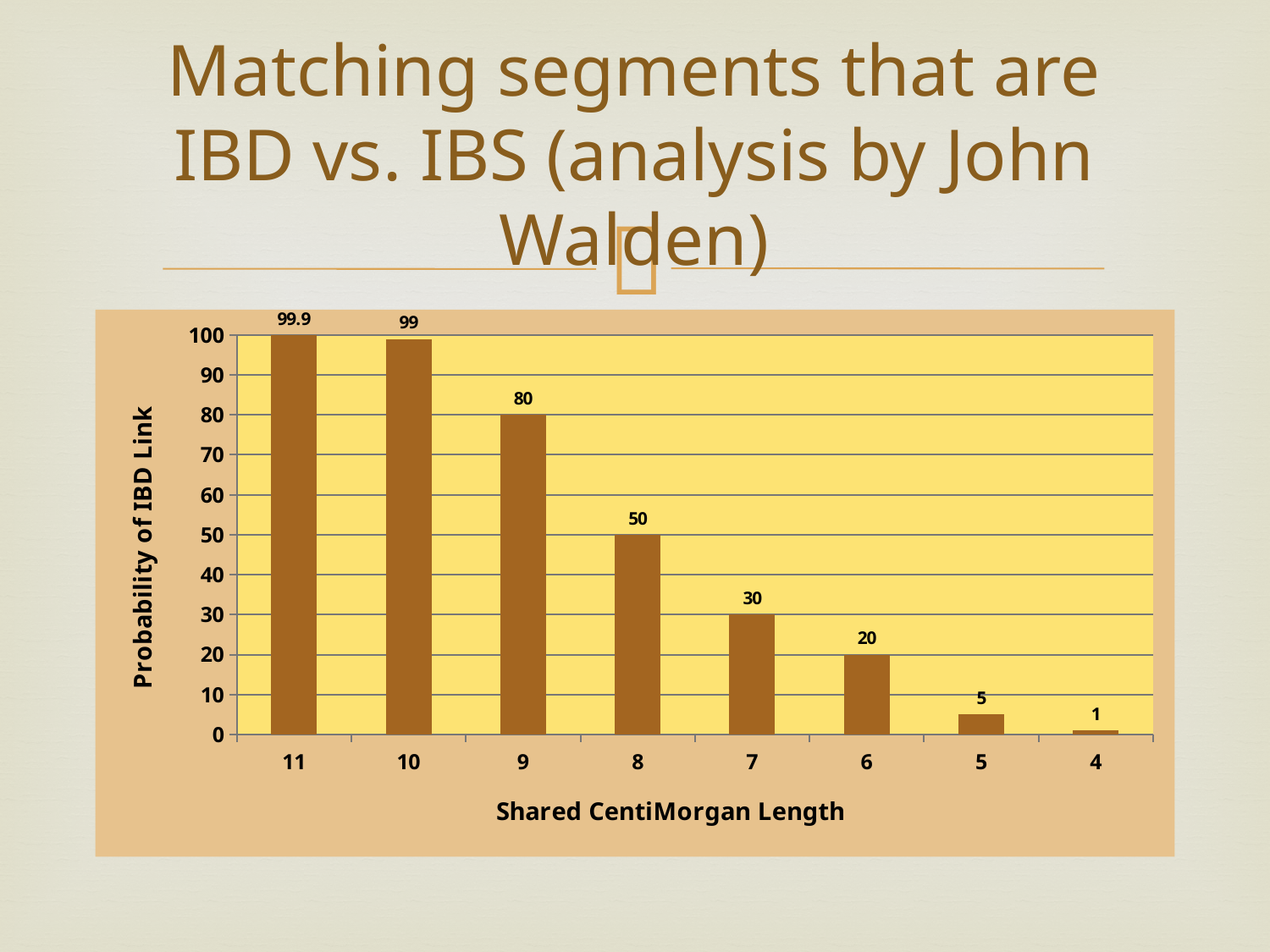
What is the probability of IBD link for a shared centiMorgan length of 11? 99.9 What is the probability of IBD link for a shared centiMorgan length of 6? 20 How many shared centiMorgan length categories are shown on the x axis? 8 What is the probability of IBD link for a shared centiMorgan length of 9? 80 Is the probability of IBD link for a shared centiMorgan length of 8 greater or less than 40? greater Which shared centiMorgan length has the highest probability of IBD link? 11 What is the difference in probability of IBD link between a shared centiMorgan length of 8 and a length of 7? 20 What kind of chart is shown on the slide? Bar chart What is the label of the y axis? Probability of IBD Link Do the values rise or fall moving from left to right along the x axis? Fall Which shared centiMorgan length has the lowest probability of IBD link? 4 Which has a higher probability of IBD link: a shared centiMorgan length of 10 or of 5? 10